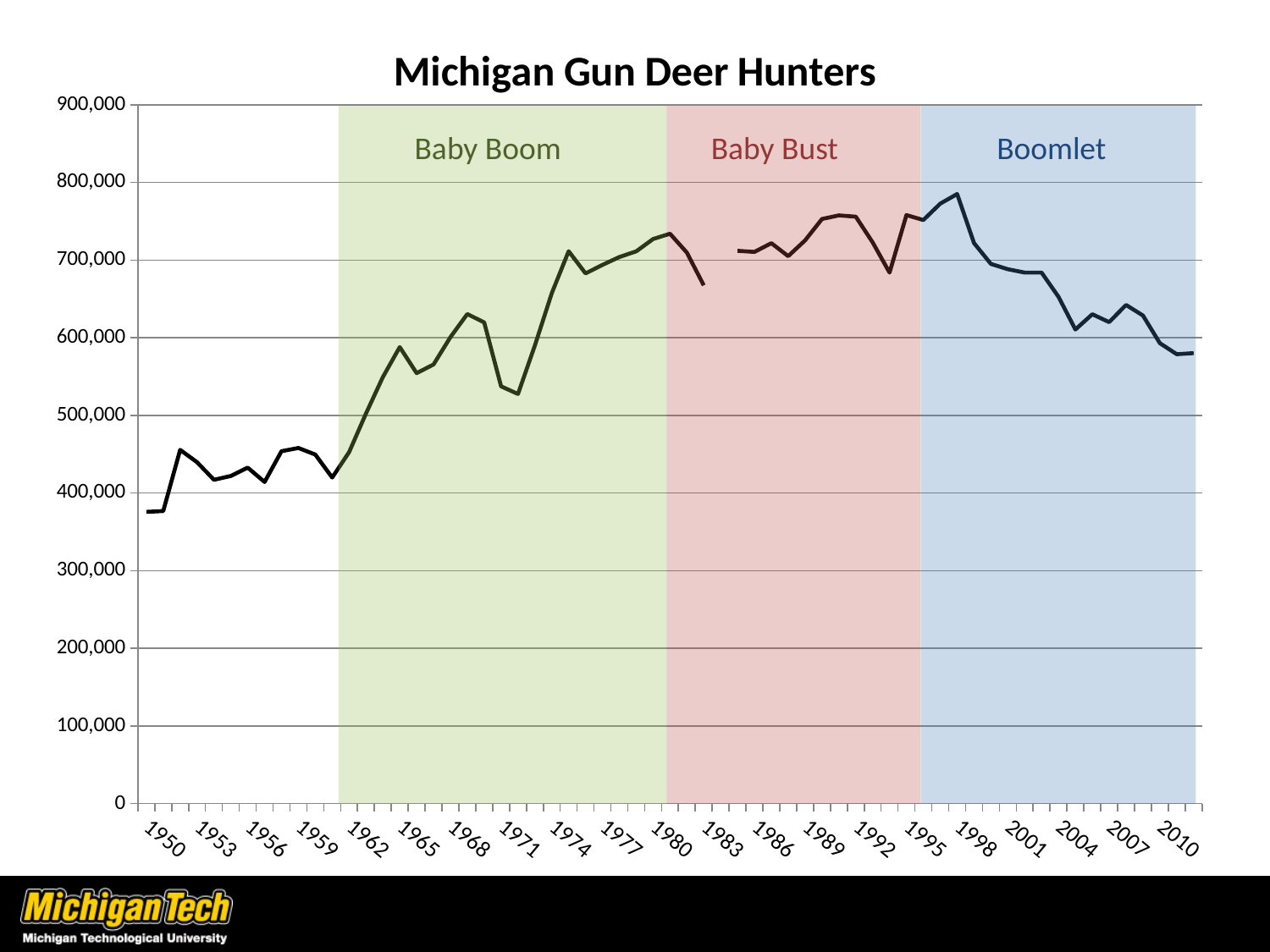
What is the title of the chart? Michigan Gun Deer Hunters Which is larger, the value for 1950 or the value for 2010? 2010 What kind of chart is shown on the slide? line chart Is the value for 1989 greater or less than 700,000? greater Is the value for 1980 greater or less than 700,000? greater Is the value for 1965 greater or less than 500,000? greater What are the three labeled shaded periods on the chart? Baby Boom, Baby Bust, Boomlet Do the values rise or fall from 1998 to 2010? fall In which labeled period does the line reach its highest value? Boomlet